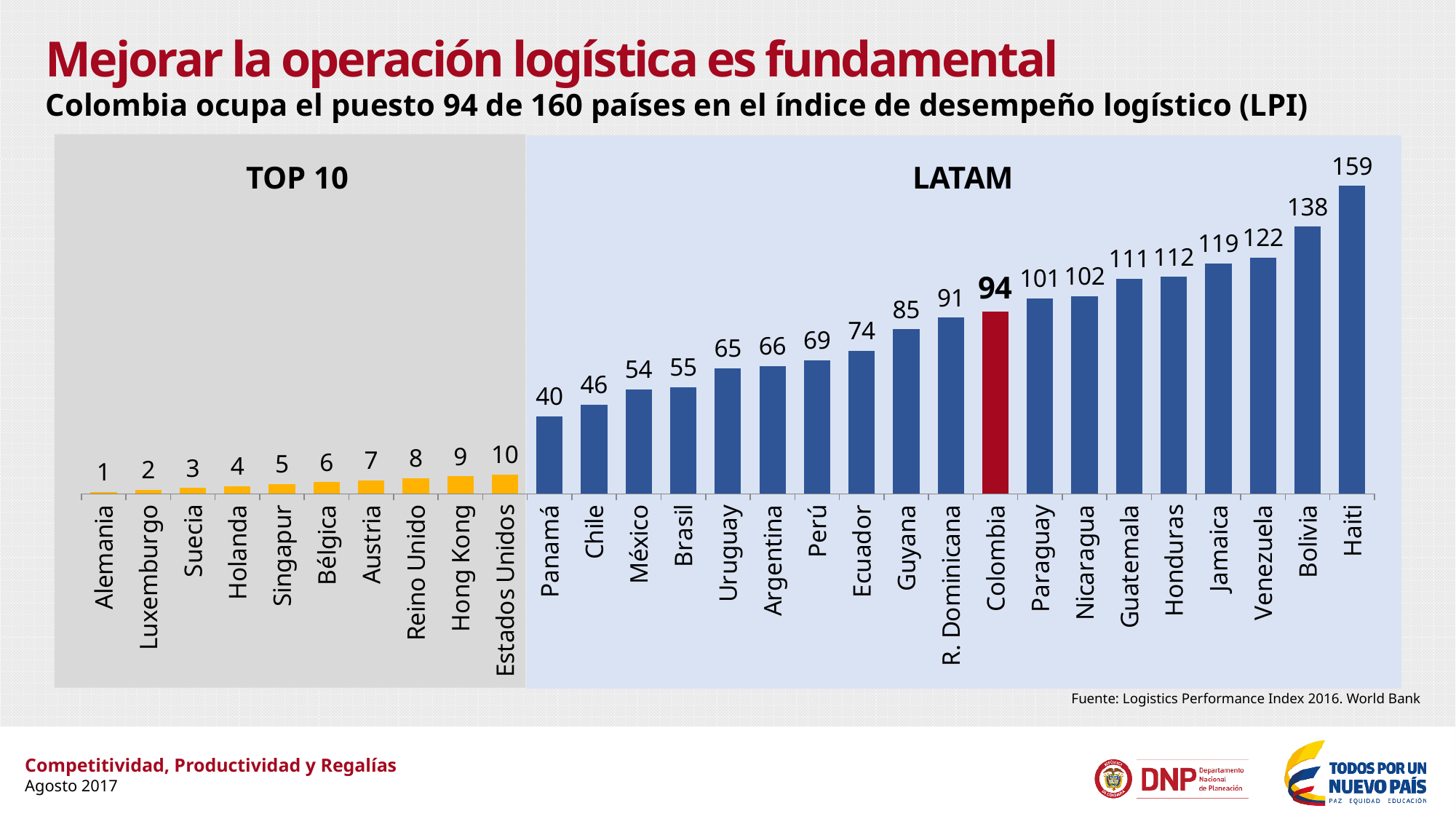
What is the LPI ranking shown for Colombia? 94 What colour is the bar for Colombia? Red How many countries are shown in the LATAM section of the chart? 19 What is the value shown for Bolivia? 138 Which country has the lowest value in the chart? Alemania What is the value shown for Chile? 46 Which LATAM country has the lowest value? Panamá What is the difference between the values for Haiti and Colombia? 65 Which has a larger value, Venezuela or Jamaica? Venezuela What kind of chart is shown on the slide? Bar chart Which country has the highest value in the chart? Haiti What is the difference between the values for Brasil and México? 1